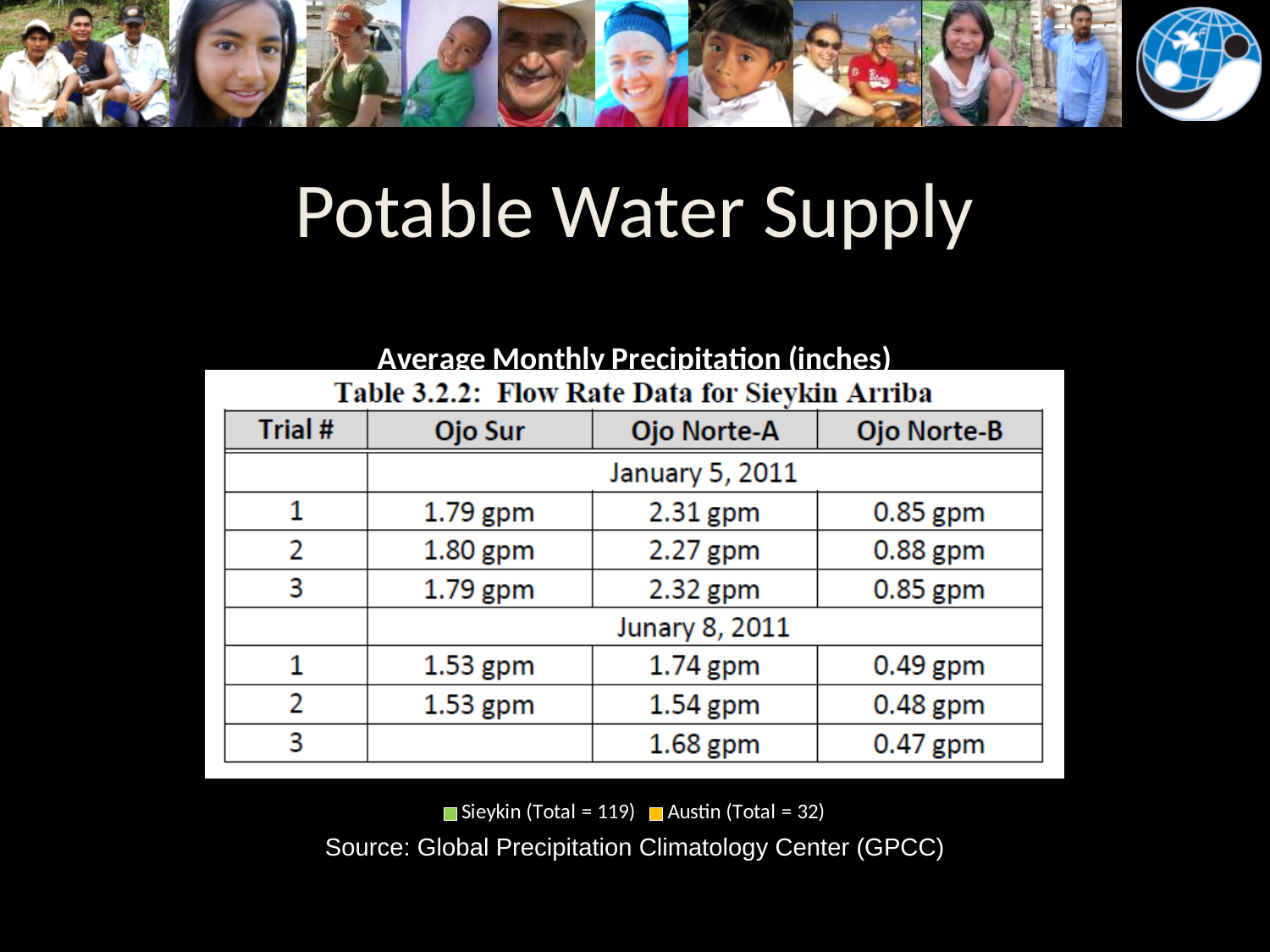
What is the title of the chart on the slide? Average Monthly Precipitation (inches) What are the two series named in the chart's legend? Sieykin and Austin How many series does the chart's legend list? 2 Is the Sieykin total shown in the chart's legend greater or less than 100? greater According to the chart's legend, what is the total for Sieykin? 119 According to the chart's legend, what is the difference between the Sieykin total and the Austin total? 87 According to the chart's legend, which series has the larger total, Sieykin or Austin? Sieykin According to the chart's legend, what is the total for Austin? 32